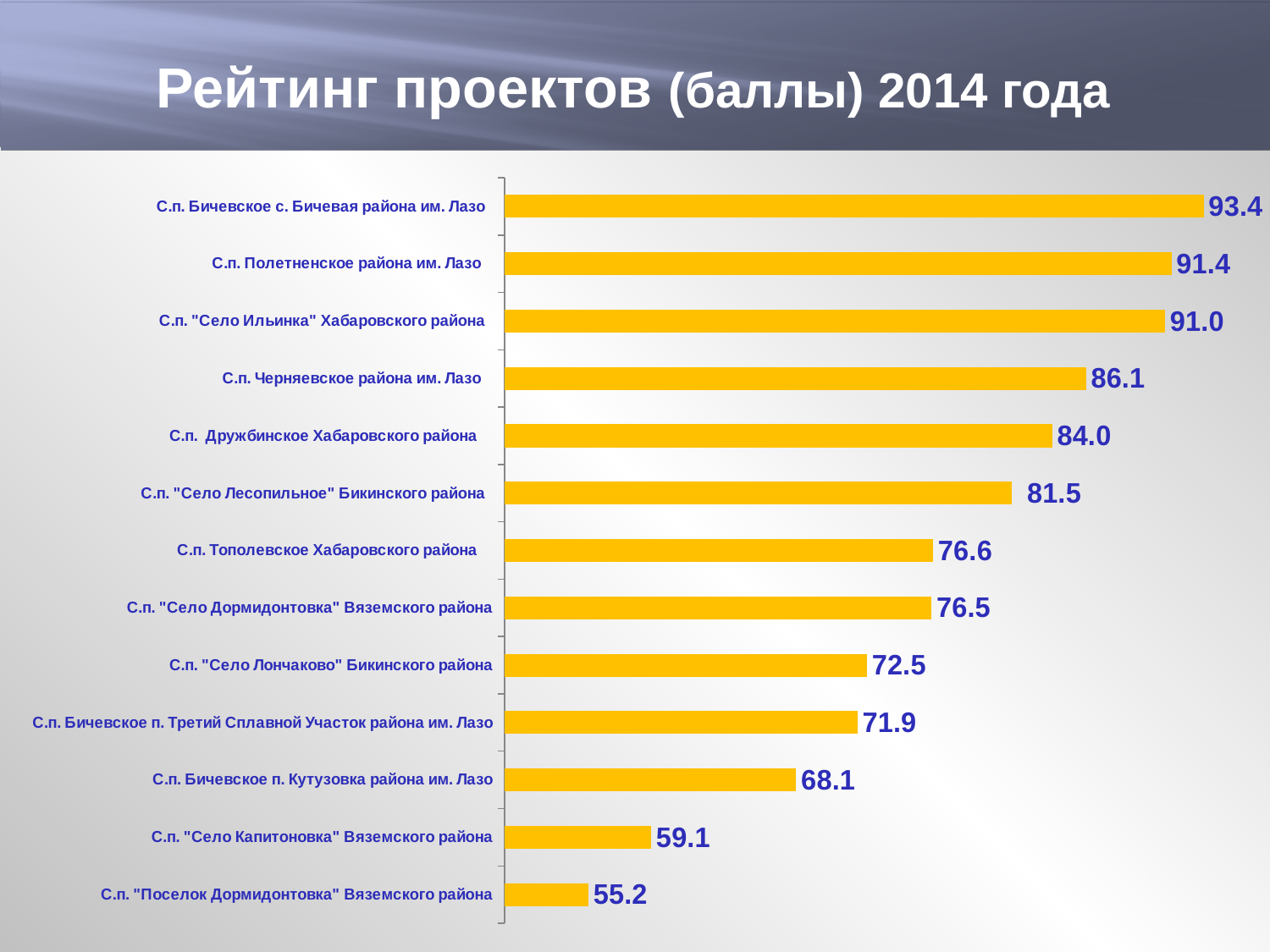
Which has a higher score: С.п. Дружбинское Хабаровского района or С.п. Тополевское Хабаровского района? С.п. Дружбинское Хабаровского района Which project has the highest score? С.п. Бичевское с. Бичевая района им. Лазо Which has a higher score: С.п. Бичевское п. Кутузовка района им. Лазо or С.п. "Село Лончаково" Бикинского района? С.п. "Село Лончаково" Бикинского района What is the score for С.п. "Село Лесопильное" Бикинского района? 81.5 What is the score for С.п. "Село Капитоновка" Вяземского района? 59.1 What is the difference between the scores of С.п. Полетненское района им. Лазо and С.п. Черняевское района им. Лазо? 5.3 Which project has the lowest score? С.п. "Поселок Дормидонтовка" Вяземского района What kind of chart is shown on the slide? Bar chart How many projects are shown on the chart? 13 What is the difference between the highest and lowest scores on the chart? 38.2 What is the score for С.п. Бичевское с. Бичевая района им. Лазо? 93.4 What is the title of the slide? Рейтинг проектов (баллы) 2014 года